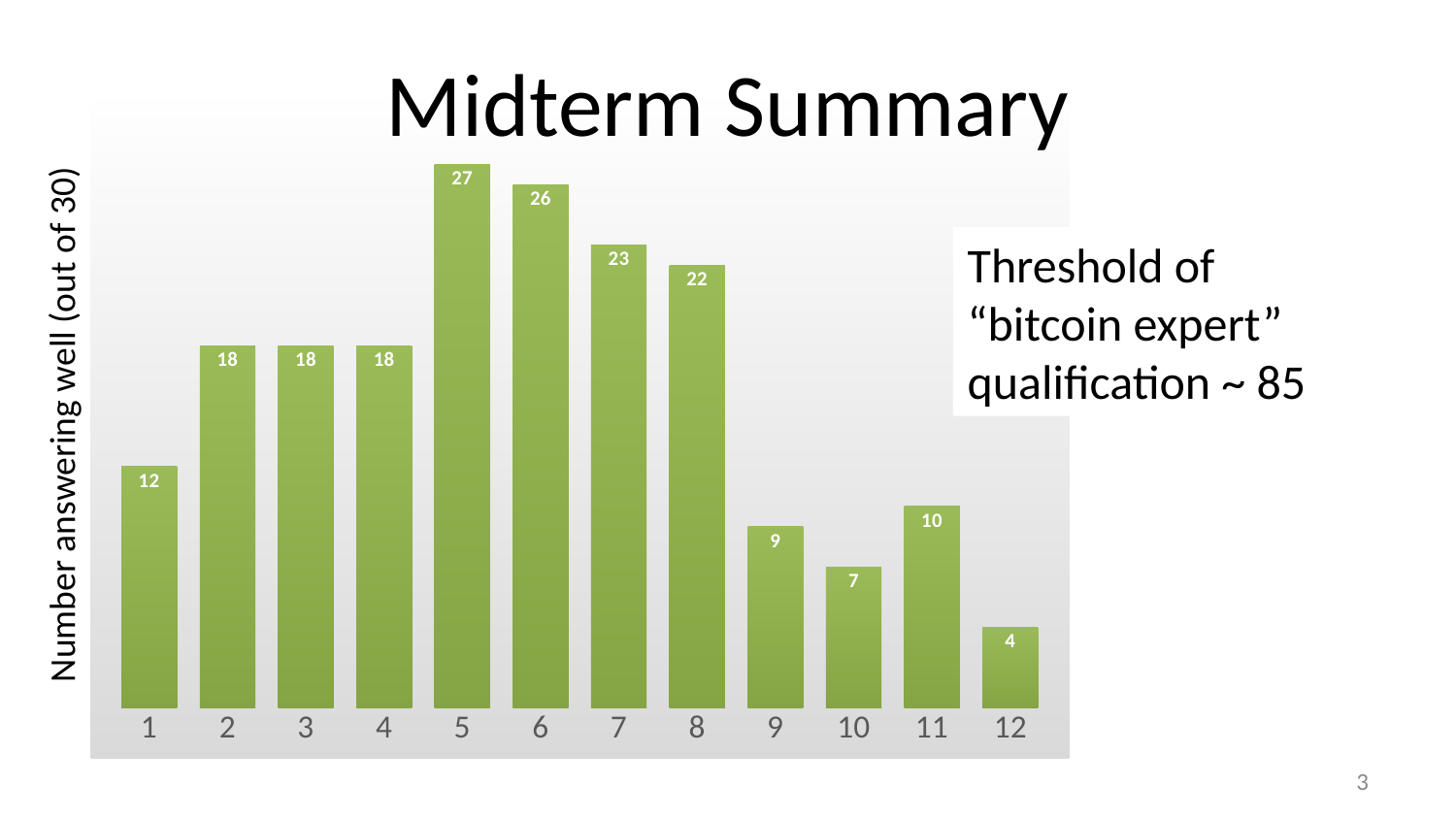
Which category has the lowest value? 12 What is the difference between the values for category 5 and category 6? 1 Do the values rise or fall from category 8 to category 10? fall How many categories are shown on the x axis? 12 What kind of chart is shown on the slide? bar chart What is the difference between the values for category 1 and category 12? 8 What is the y-axis label of the chart? Number answering well (out of 30) Which is larger, the value for category 9 or the value for category 11? 11 Which category has the highest value? 5 What is the value for category 12? 4 What is the value for category 8? 22 What is the value for category 5? 27